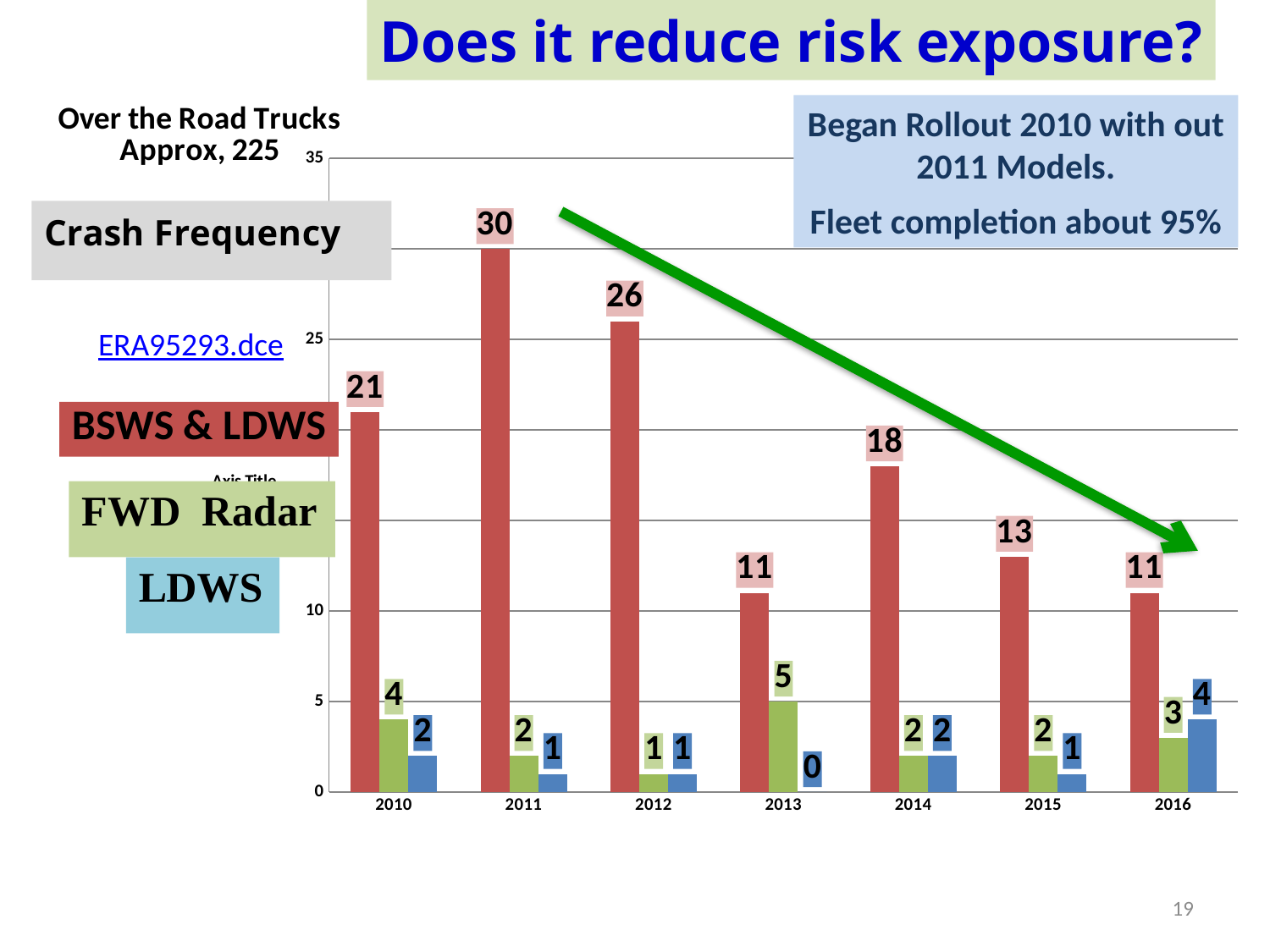
In which year is the red (BSWS & LDWS) bar highest? 2011 What is the value of the green (FWD Radar) bar for 2010? 4 How many years are shown on the x axis? 7 What is the difference between the red (BSWS & LDWS) values for 2011 and 2016? 19 What is the value of the blue (LDWS) bar for 2016? 4 What is the value of the red (BSWS & LDWS) bar for 2011? 30 What is the value of the green (FWD Radar) bar for 2013? 5 Is the red (BSWS & LDWS) value for 2010 greater or less than 20? greater What type of chart is shown on the slide? bar chart How many data series are plotted in the chart? 3 In which year is the blue (LDWS) bar lowest? 2013 Which is larger, the red (BSWS & LDWS) value for 2012 or for 2014? 2012